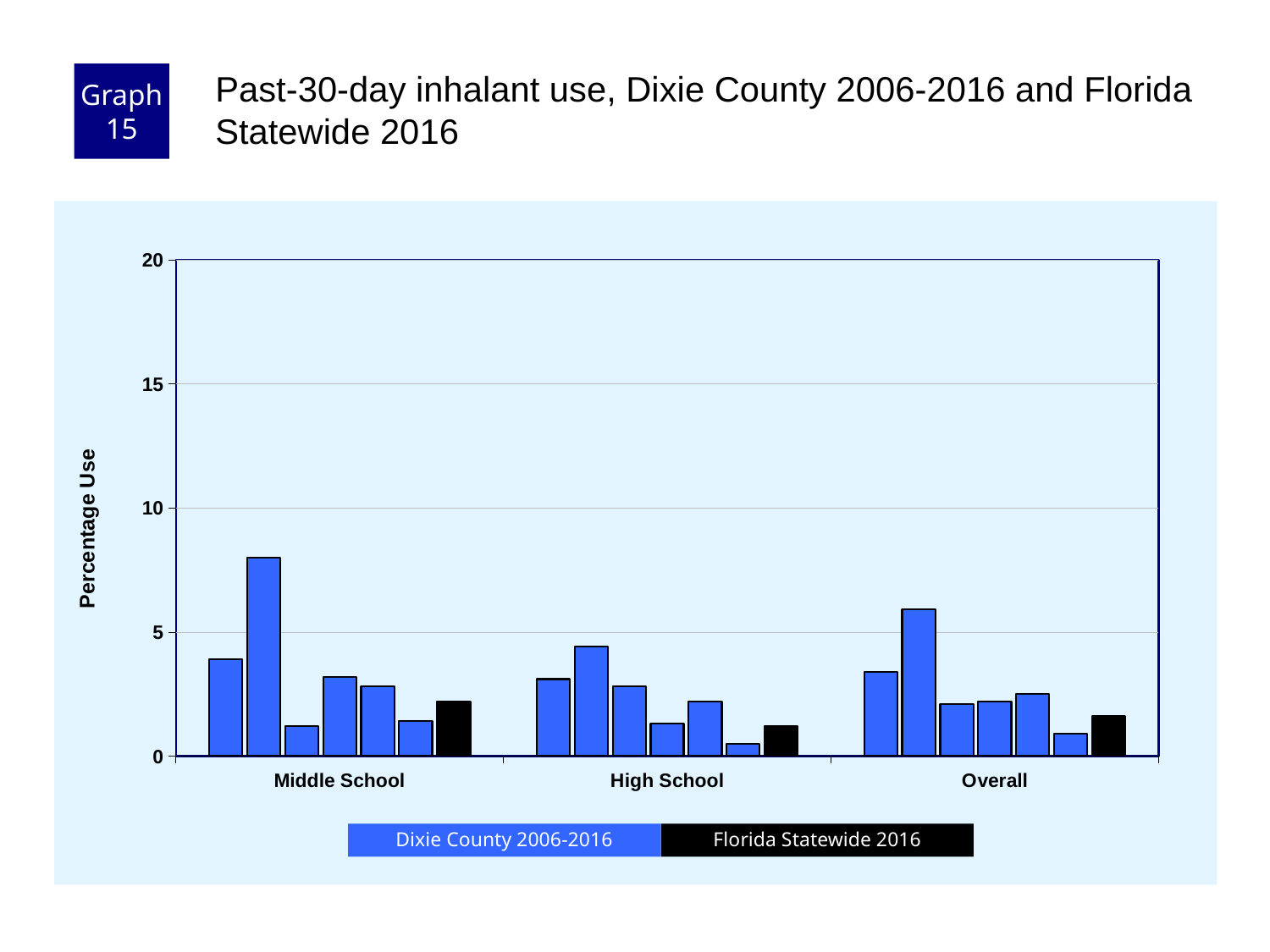
Is the tallest bar in the Middle School group greater or less than 5? greater What kind of chart is shown on the slide? bar chart What is the label on the y axis? Percentage Use Which group contains the tallest bar on the chart? Middle School How many school-level categories are shown on the x axis? 3 Is the highest value anywhere on the chart greater or less than 10? less Is the tallest bar in the High School group greater or less than 5? less How many series does the legend list? 2 Is the Florida Statewide 2016 value larger for Middle School or for High School? Middle School What are the two series named in the legend? Dixie County 2006-2016 and Florida Statewide 2016